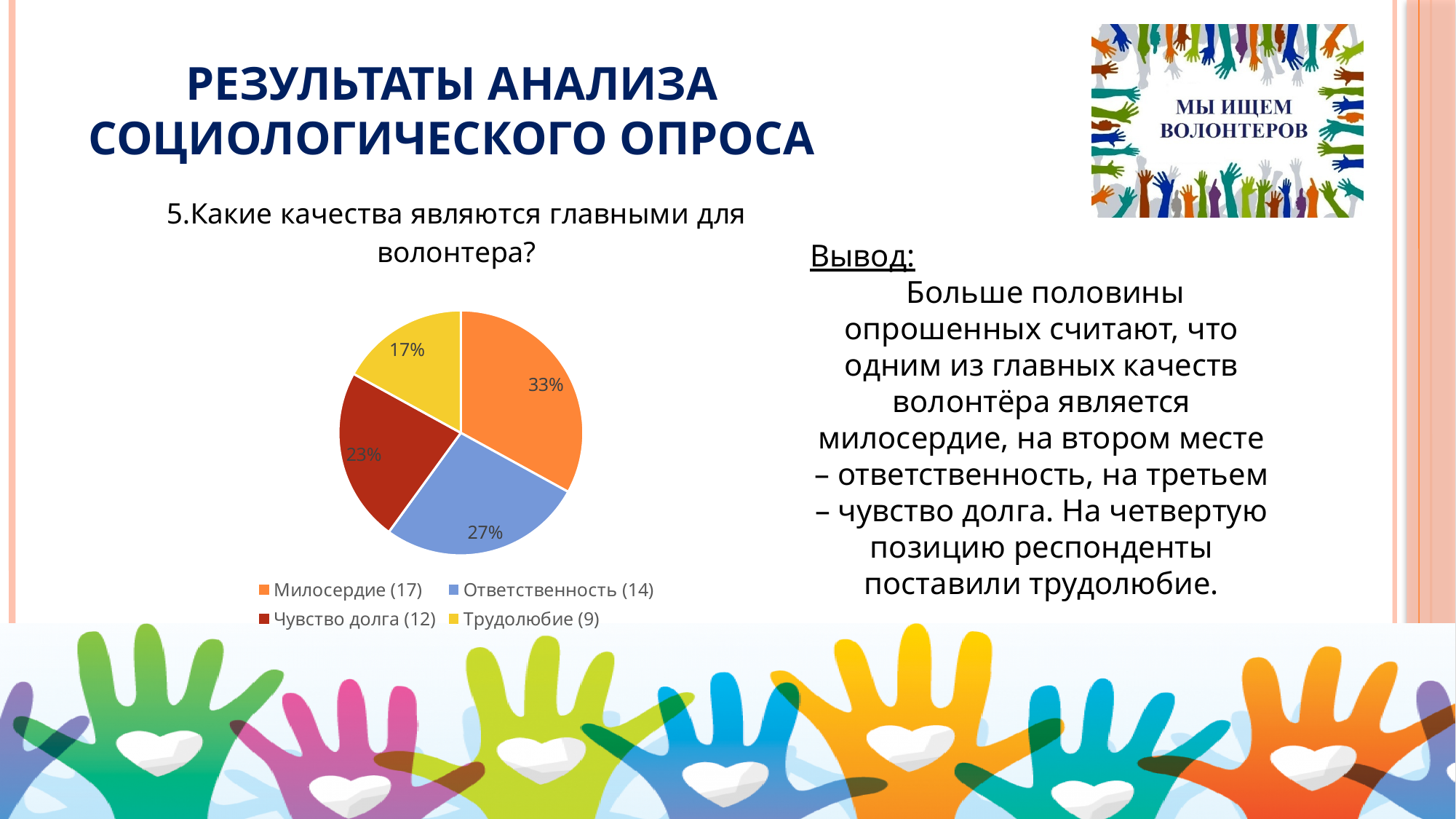
Which category has the largest slice of the pie? Милосердие (17) What percentage of the pie does Чувство долга (12) take? 23% What percentage of the pie does Ответственность (14) take? 27% How many slices does the pie chart have? 4 Which slice is larger: Ответственность (14) or Чувство долга (12)? Ответственность (14) What type of chart is shown on the slide? pie chart What percentage of the pie does Милосердие (17) take? 33% What is the title of the pie chart? 5.Какие качества являются главными для волонтера? Which category has the smallest slice of the pie? Трудолюбие (9) What colour is the Чувство долга (12) slice in the pie chart? dark red What is the difference in percentage points between the Милосердие (17) slice and the Трудолюбие (9) slice? 16%